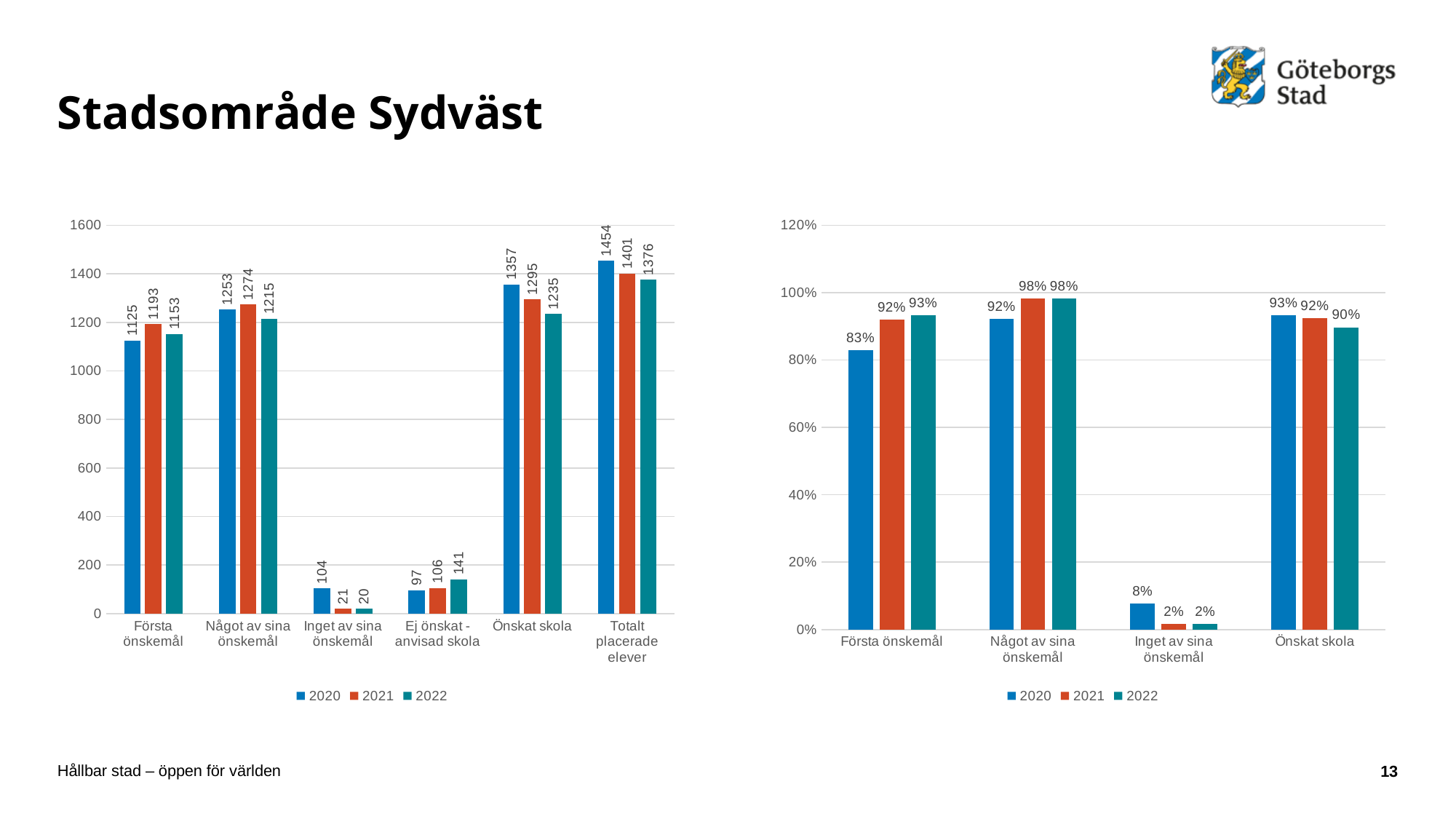
In the left chart, which category has the lowest value for the 2022 series? Inget av sina önskemål In the left chart, what is the value for 2021 in the 'Totalt placerade elever' category? 1401 In the left chart, what is the difference between the 2020 and 2022 values for 'Totalt placerade elever'? 78 In the left chart, what is the value for 2022 in the 'Ej önskat - anvisad skola' category? 141 How many series does the legend of the right chart list? 3 In the right chart, do the values for 'Första önskemål' rise or fall from 2020 to 2022? rise In the left chart, how many categories are shown on the x axis? 6 In the right chart, what is the value for 2022 in the 'Önskat skola' category? 90% In the right chart, what is the value for 2020 in the 'Första önskemål' category? 83% In the left chart, which category has the highest value for the 2020 series? Totalt placerade elever In the right chart, which is larger for 'Inget av sina önskemål': the 2020 value or the 2021 value? 2020 What kind of chart is the left chart? bar chart